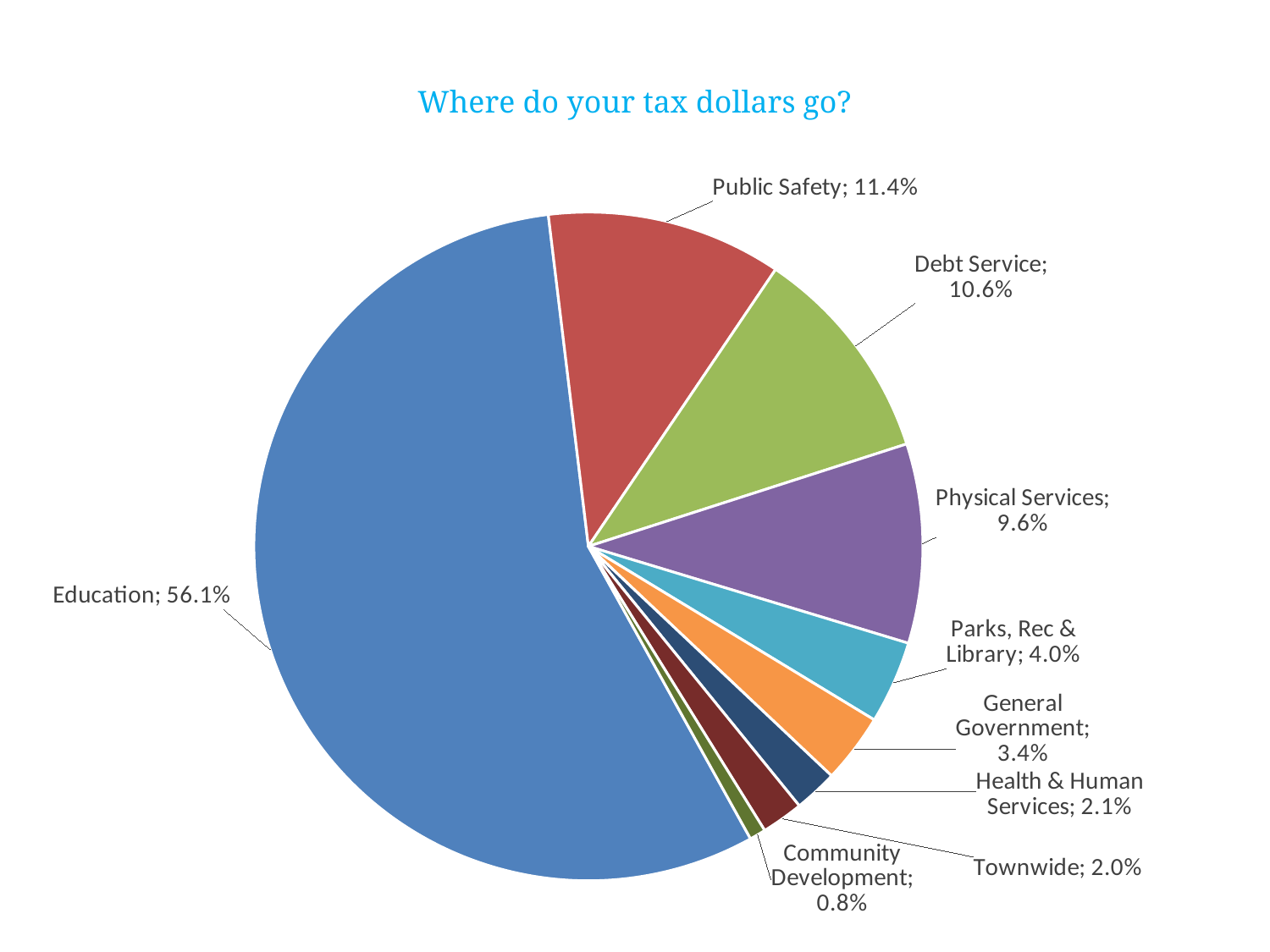
How many slices does the pie chart have? 9 What is the combined share of Health & Human Services and Townwide? 4.1% What colour is the Education slice? blue What percentage is shown for Parks, Rec & Library? 4.0% What is the difference between the Public Safety and Debt Service percentages? 0.8% Which is larger, Physical Services or Public Safety? Public Safety What is the title of the chart? Where do your tax dollars go? What percentage is shown for Debt Service? 10.6% Which category has the smallest slice of the pie? Community Development What share of tax dollars goes to Education? 56.1% What kind of chart is shown on the slide? pie chart Which category has the largest slice of the pie? Education